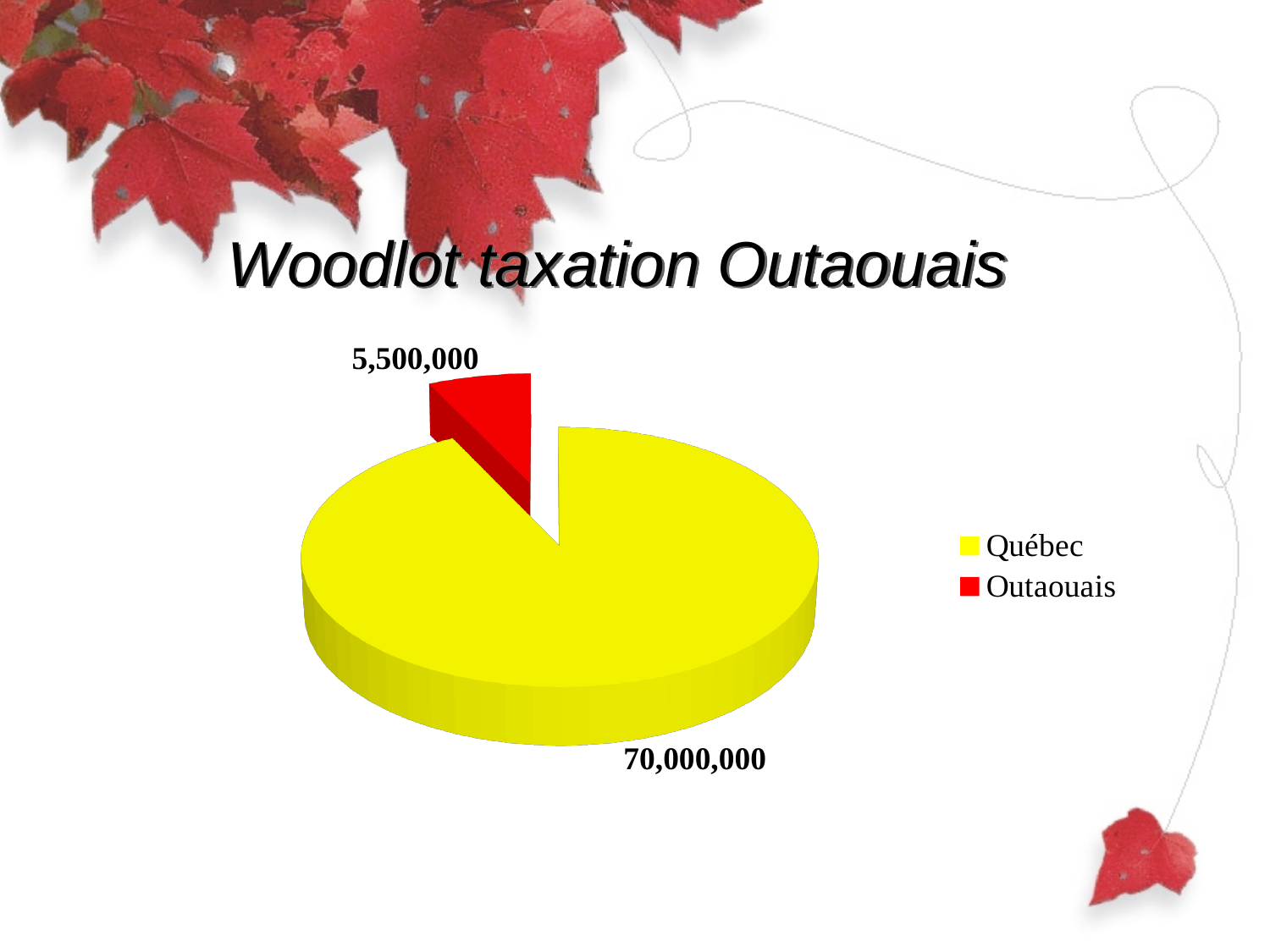
What is the difference between the Québec value and the Outaouais value? 64,500,000 Which is larger, the value for Québec or the value for Outaouais? Québec What colour is the Outaouais slice in the pie chart? Red What is the title of the chart on the slide? Woodlot taxation Outaouais What kind of chart is shown on the slide? Pie chart Which category has the largest slice in the pie chart? Québec What is the total of the two values shown in the pie chart? 75,500,000 What is the value for Québec in the pie chart? 70,000,000 Which category has the smallest slice in the pie chart? Outaouais How many slices does the pie chart have? 2 How many entries does the legend list? 2 What is the value for Outaouais in the pie chart? 5,500,000